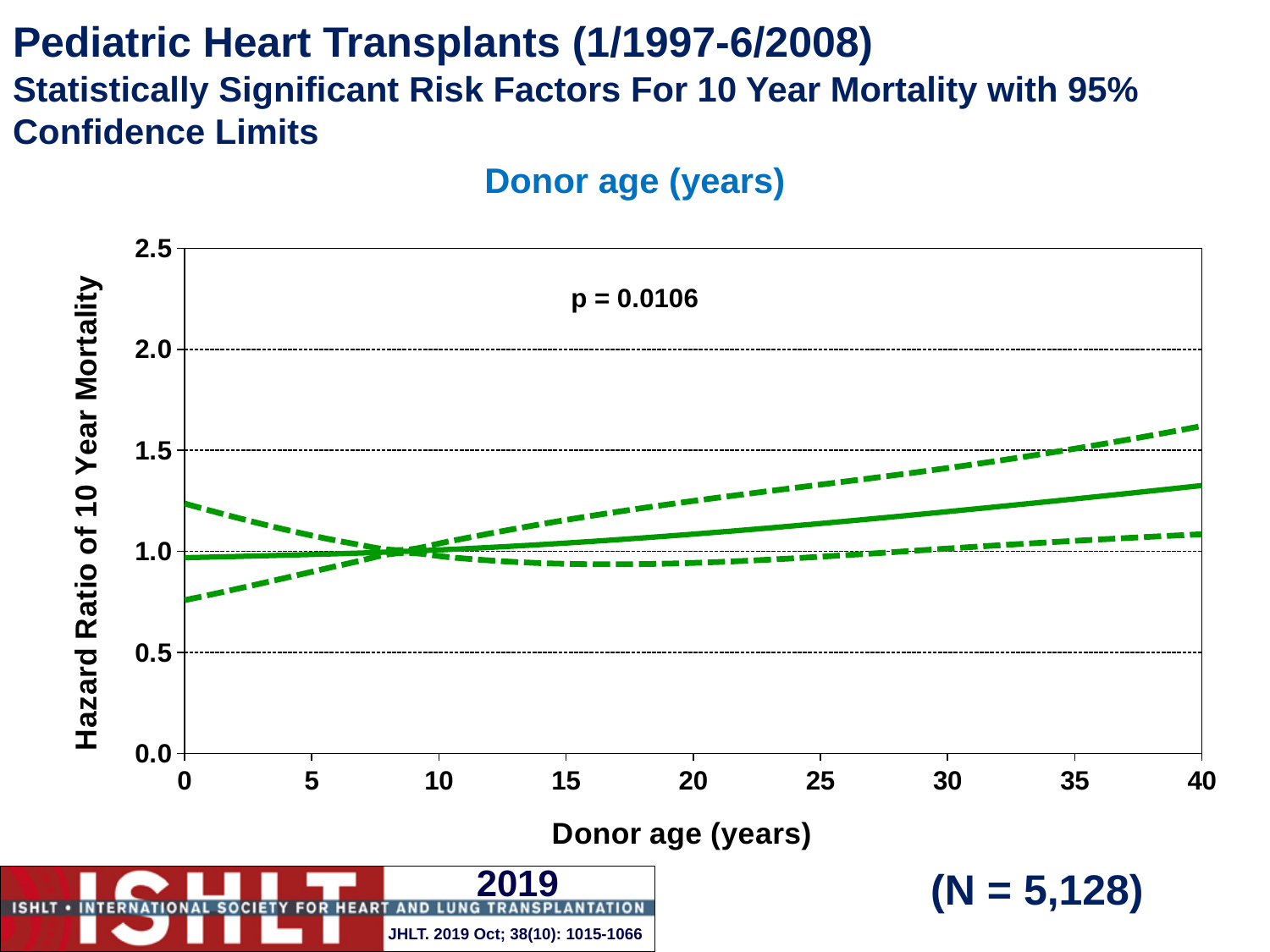
What is the maximum value shown on the y axis of the chart? 2.5 Which is larger at donor age 40: the upper dashed confidence limit or the solid hazard ratio line? the upper dashed confidence limit Is the value of the upper dashed confidence limit at donor age 40 greater or less than 1.5? greater What is the title of the chart? Donor age (years) Is the value of the lower dashed confidence limit at donor age 20 greater or less than 1.0? less What kind of chart is shown on the slide? line chart Is the value of the solid hazard ratio line at donor age 40 greater or less than 1.5? less Does the solid hazard ratio line rise or fall as donor age increases from 10 to 40 years? rise What p-value is printed on the chart? p = 0.0106